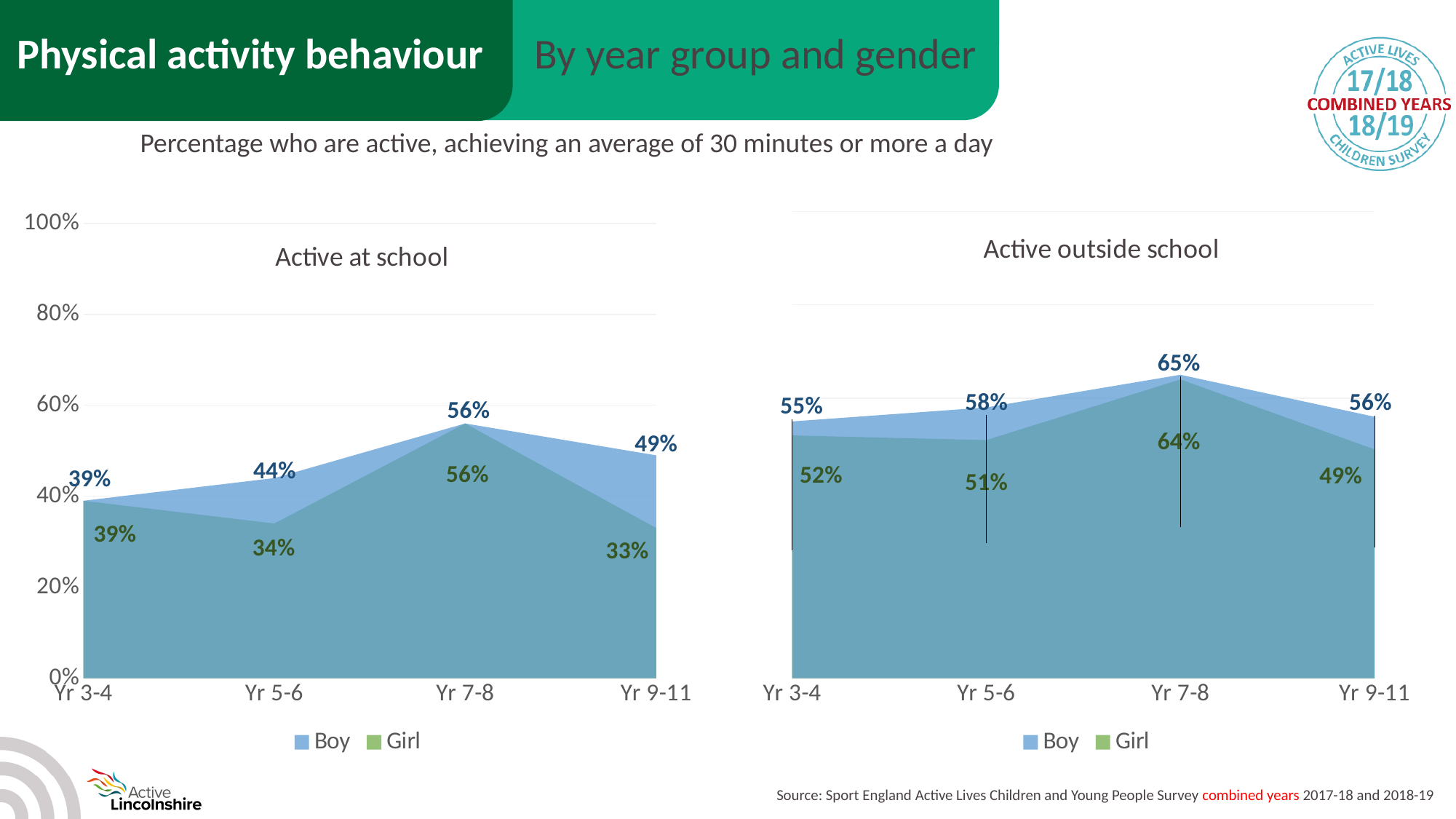
In the 'Active outside school' chart, which year group has the highest value for Boy? Yr 7-8 How many series does the legend of the 'Active outside school' chart list? 2 In the 'Active outside school' chart, does the Boy value rise or fall from Yr 7-8 to Yr 9-11? Fall In the 'Active at school' chart, what is the value for Girl in Yr 5-6? 34% In the 'Active outside school' chart, what is the value for Boy in Yr 3-4? 55% What kind of chart is the 'Active at school' chart? Area chart In the 'Active outside school' chart, which is larger in Yr 5-6: the Boy value or the Girl value? Boy How many year groups are shown on the x axis of the 'Active at school' chart? 4 In the 'Active outside school' chart, what is the value for Girl in Yr 9-11? 49% In the 'Active at school' chart, what is the value for Boy in Yr 7-8? 56% In the 'Active at school' chart, which year group has the lowest value for Girl? Yr 9-11 In the 'Active at school' chart, what is the difference between the Boy and Girl values in Yr 9-11? 16%